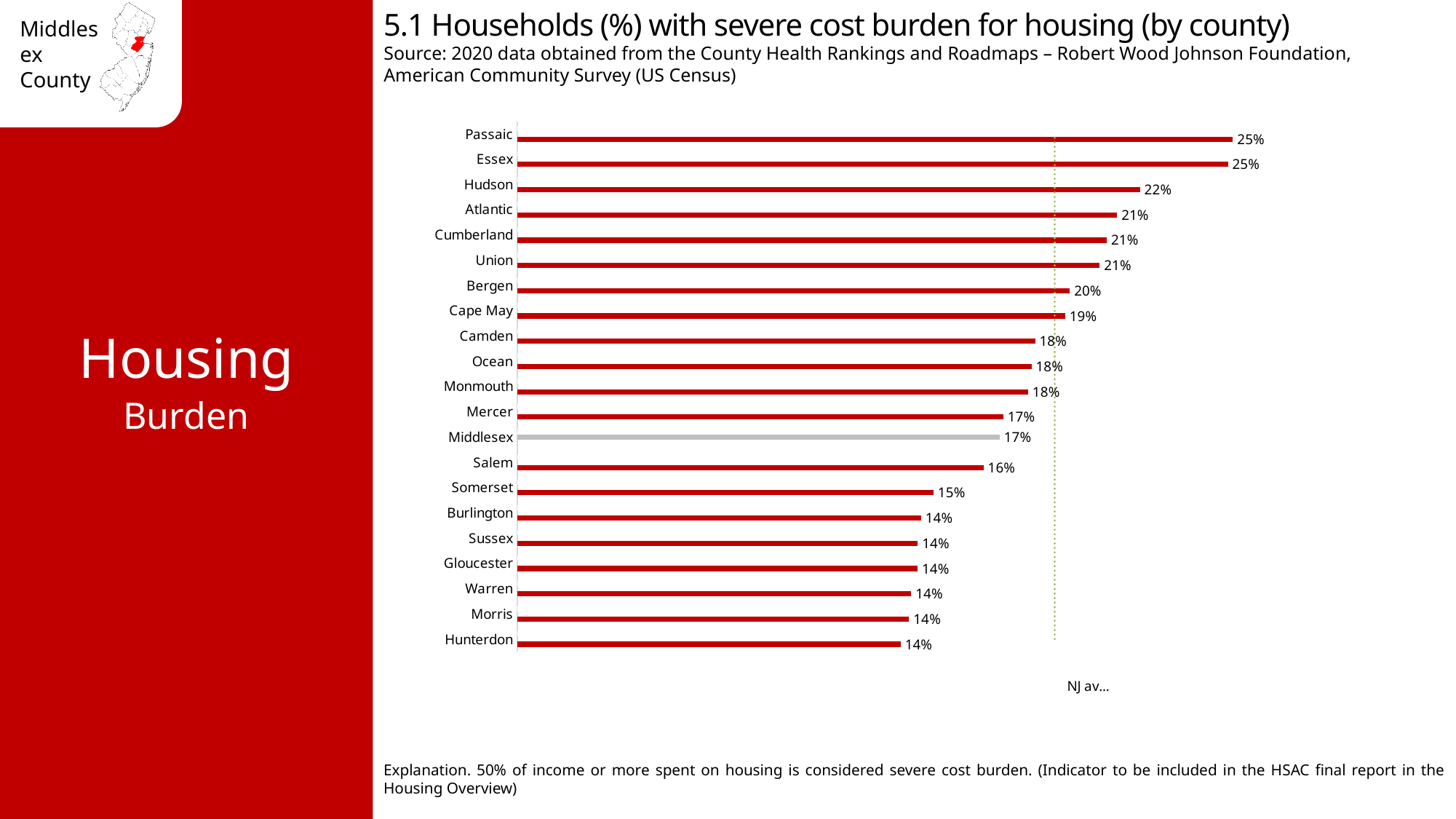
What is the value for Bergen? 20% What is the value for Cape May? 19% How many counties are shown in the chart? 21 What is the value for Middlesex? 17% What is the difference between the values for Hudson and Hunterdon? 8 percentage points What is the difference between the values for Passaic and Middlesex? 8 percentage points Which has a higher value, Somerset or Cape May? Cape May What kind of chart is shown on the slide? Bar chart What is the value for Somerset? 15% Which has a higher value, Hudson or Bergen? Hudson What is the value for Hudson? 22% Which county's bar is drawn in gray instead of red? Middlesex